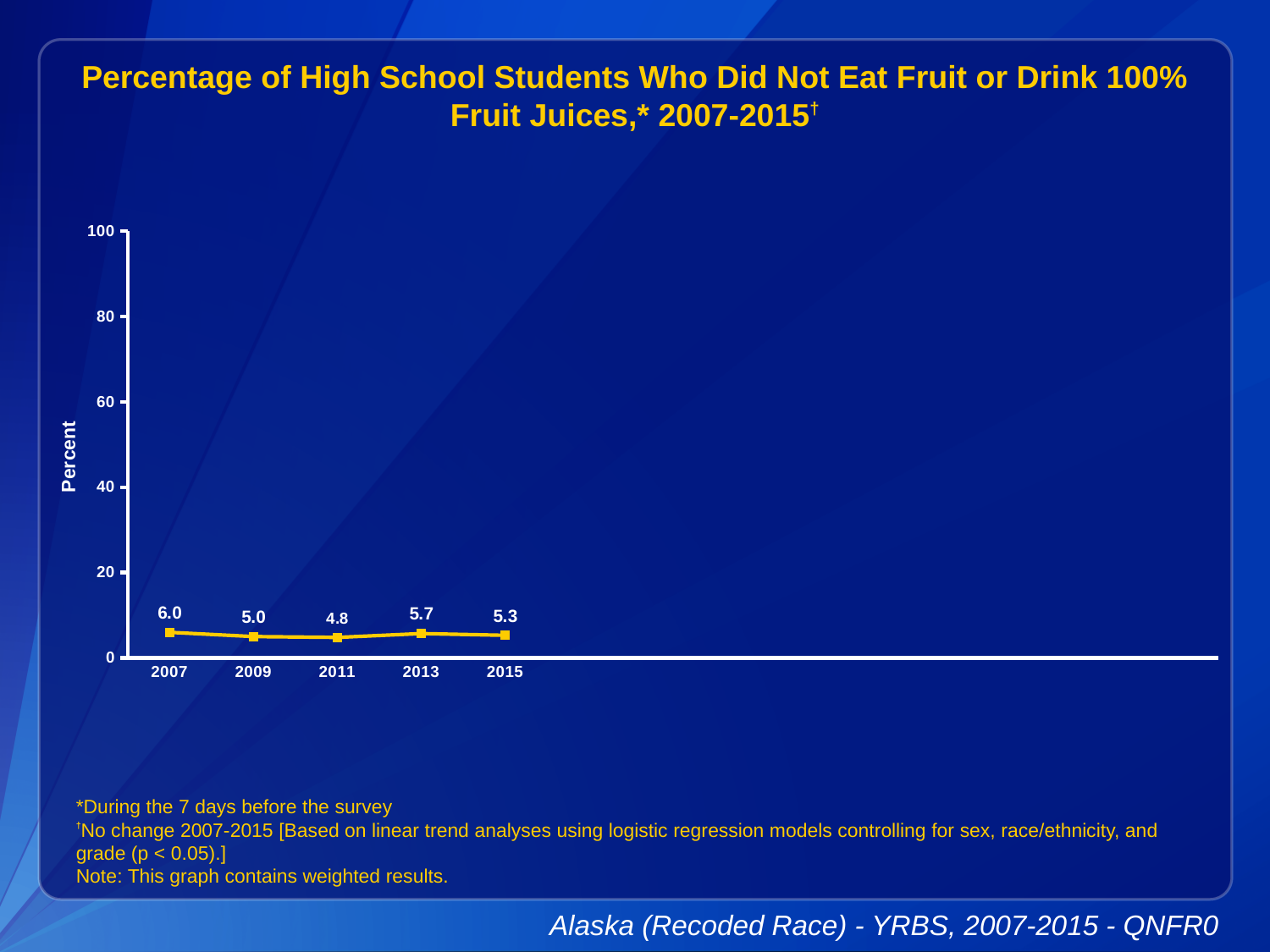
What is the difference between the values for 2007 and 2011? 1.2 Does the value rise or fall from 2007 to 2009? fall Which year has the lowest value? 2011 What is the label on the y axis? Percent What is the value for 2011? 4.8 Which is larger, the value for 2013 or the value for 2015? 2013 Is the value for 2009 greater or less than 20? less What is the value for 2015? 5.3 How many years are plotted on the chart? 5 What is the value for 2007? 6.0 What kind of chart is shown? line chart Which year has the highest value? 2007